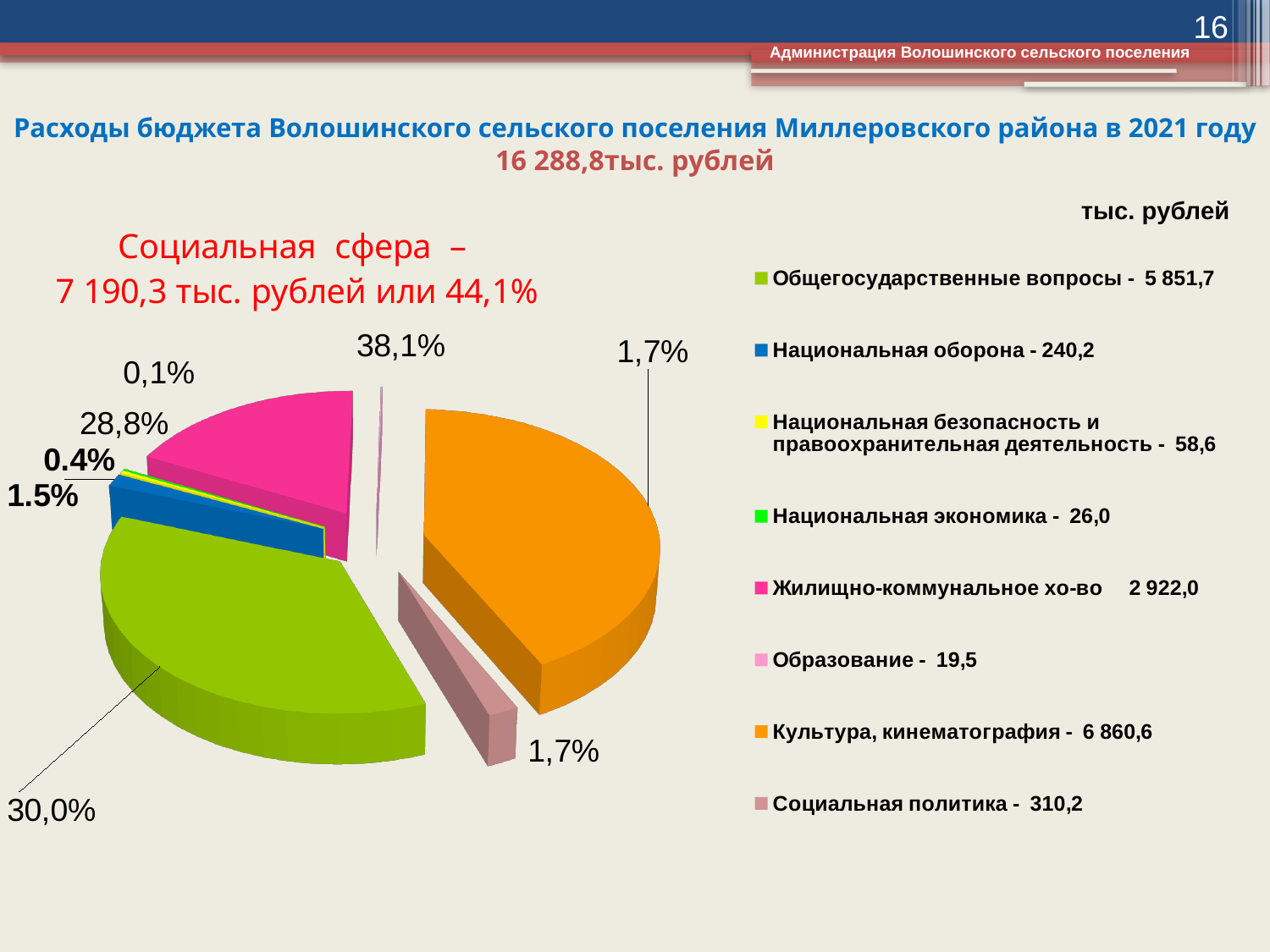
How many categories does the legend list? 8 Which is larger: the value for Национальная оборона or the value for Социальная политика? Социальная политика Which category has the highest value in the legend? Культура, кинематография What total budget expenditure is stated in the slide title? 16 288,8тыс. рублей What kind of chart is shown on the slide? pie chart What is the value for Жилищно-коммунальное хо-во? 2 922,0 What is the value for Культура, кинематография? 6 860,6 What is the difference between the values for Культура, кинематография and Общегосударственные вопросы? 1 008,9 Which category has the lowest value in the legend? Образование What is the value for Общегосударственные вопросы? 5 851,7 What is the value for Образование? 19,5